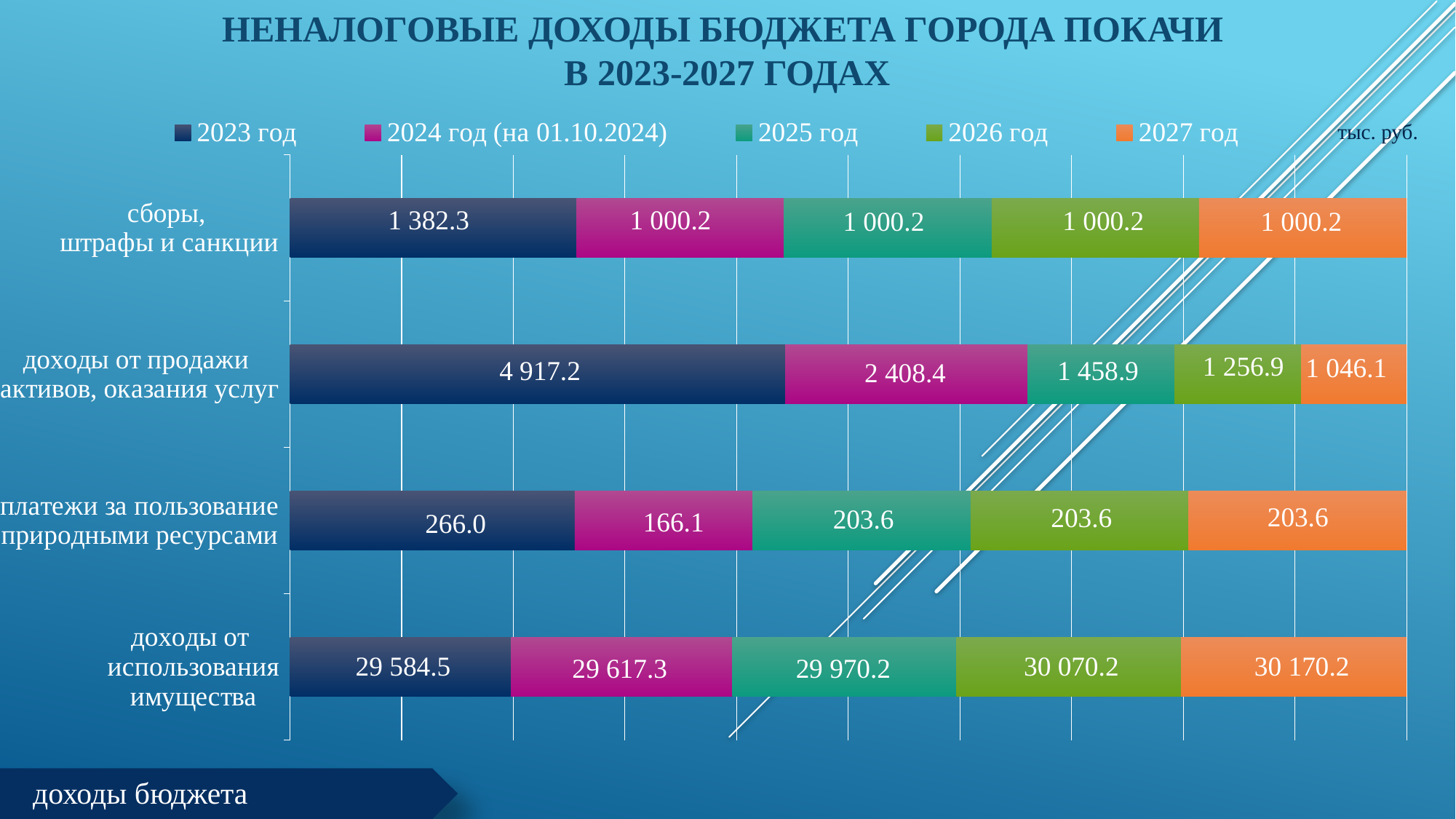
What is the value for 2027 год in the category «доходы от использования имущества»? 30 170.2 What kind of chart is shown on the slide? bar chart How many categories are shown on the chart? 4 For «доходы от использования имущества», which is larger: the value for 2026 год or for 2027 год? 2027 год Which category has the highest value for 2023 год? доходы от использования имущества What is the value for 2024 год (на 01.10.2024) in the category «доходы от продажи активов, оказания услуг»? 2 408.4 What is the difference between the 2023 год and 2024 год (на 01.10.2024) values for «доходы от продажи активов, оказания услуг»? 2 508.8 What is the value for 2025 год in the category «платежи за пользование природными ресурсами»? 203.6 Which category has the lowest value for 2024 год (на 01.10.2024)? платежи за пользование природными ресурсами Do the values for «доходы от продажи активов, оказания услуг» rise or fall from 2023 год to 2027 год? fall What is the value for 2023 год in the category «сборы, штрафы и санкции»? 1 382.3 How many series does the legend list? 5